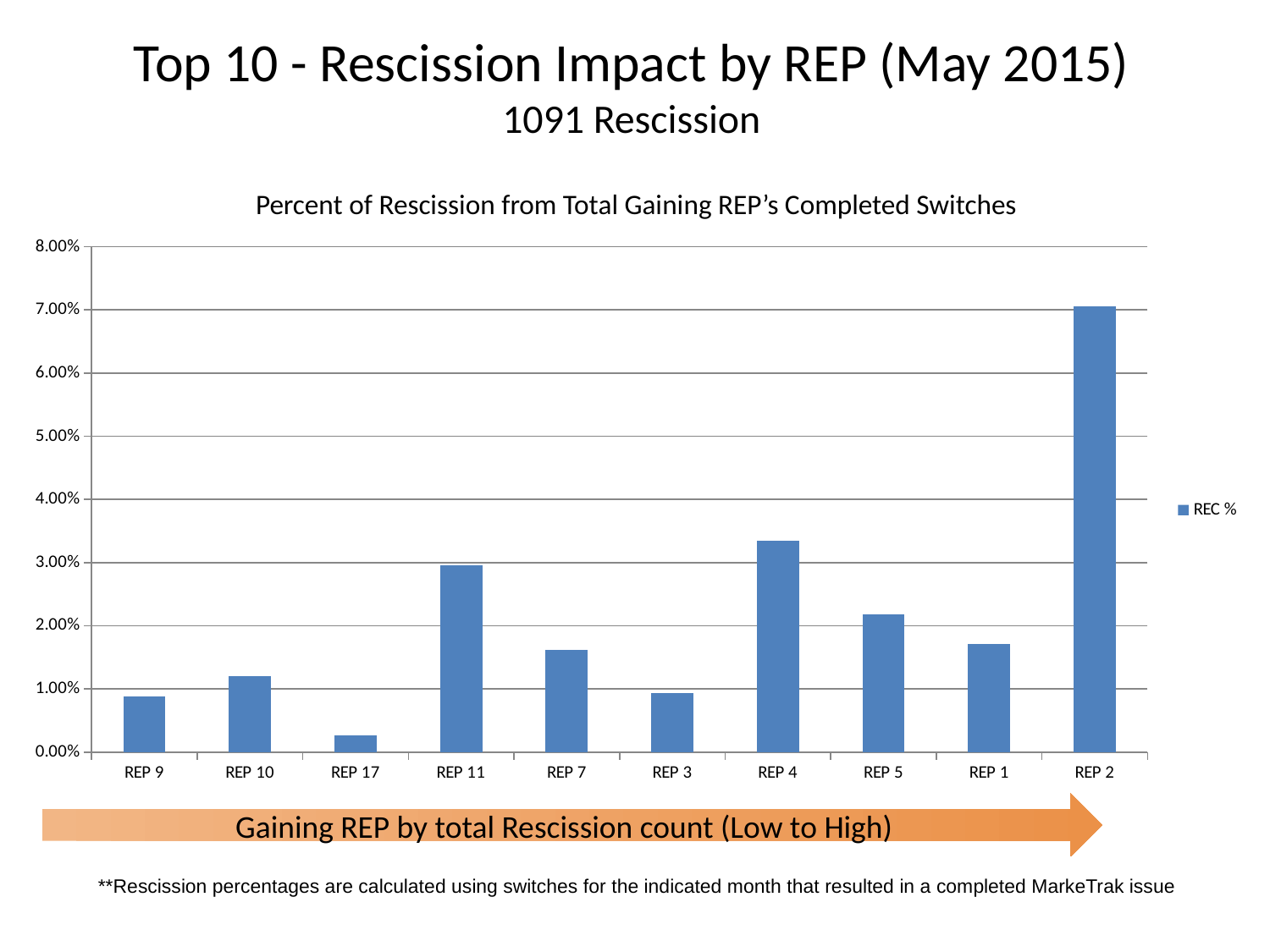
How many series does the chart legend list? 1 Which has a larger REC % value, REP 5 or REP 1? REP 5 What kind of chart is shown on the slide? Bar chart Which REP has the highest REC % value? REP 2 Is the value for REP 5 greater or less than 2.00%? greater Is the value for REP 4 greater or less than 3.00%? greater Which REP has the lowest REC % value? REP 17 What is the name of the series listed in the chart legend? REC % How many REPs are shown on the x axis of the chart? 10 Which has a larger REC % value, REP 4 or REP 11? REP 4 Is the value for REP 2 greater or less than 6.00%? greater